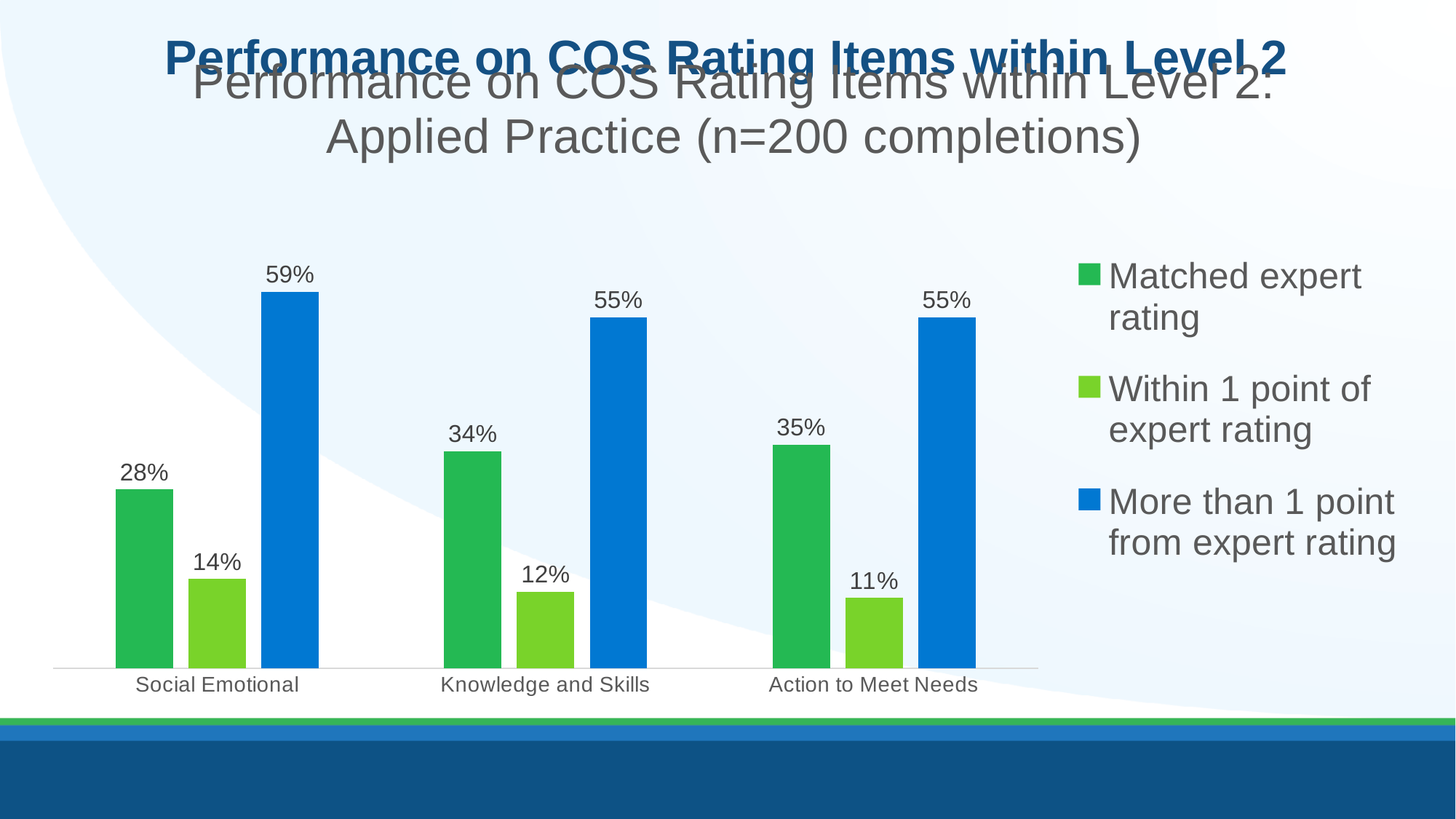
What percentage was within 1 point of the expert rating for Knowledge and Skills? 12% For Knowledge and Skills, which is larger: 'Matched expert rating' or 'Within 1 point of expert rating'? Matched expert rating What is the difference between the 'More than 1 point from expert rating' and 'Matched expert rating' values for Social Emotional? 31% How many categories are shown on the x axis? 3 What is the difference between the 'Matched expert rating' values for Action to Meet Needs and Social Emotional? 7% What percentage was more than 1 point from the expert rating for Action to Meet Needs? 55% Which category has the highest value for 'More than 1 point from expert rating'? Social Emotional Which category has the lowest value for 'Within 1 point of expert rating'? Action to Meet Needs Which colour represents 'Matched expert rating' in the legend? Green What kind of chart is shown on the slide? Bar chart What percentage matched the expert rating for Social Emotional? 28% How many series does the legend list? 3